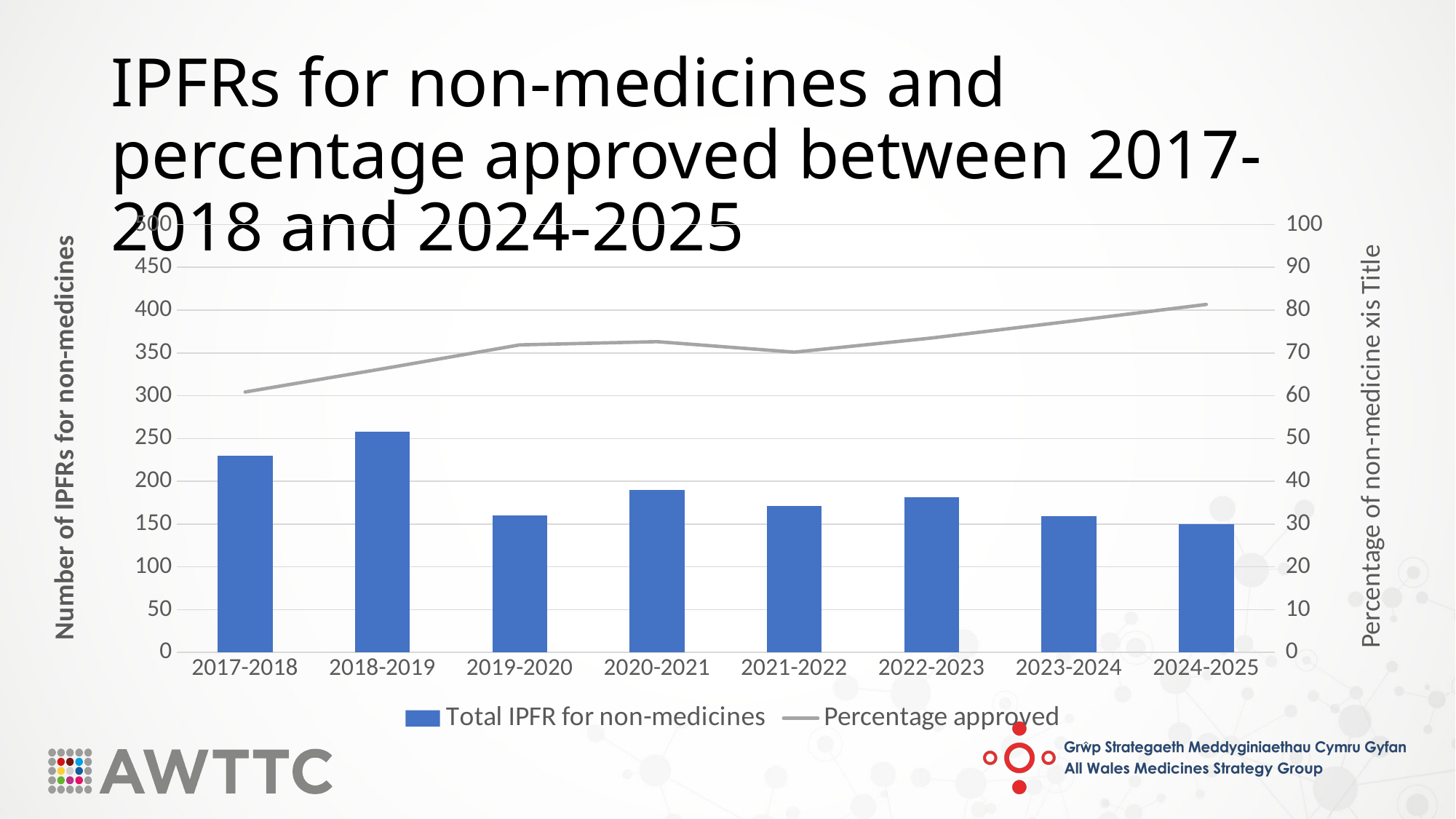
How many financial-year categories are shown on the x axis? 8 Which year has the lowest Total IPFR for non-medicines? 2024-2025 Does the Percentage approved line generally rise or fall from 2017-2018 to 2024-2025? Rise Is the Percentage approved in 2024-2025 greater or less than 70? greater Is the Total IPFR for non-medicines in 2019-2020 greater or less than 200? less Which year has the lowest Percentage approved? 2017-2018 How many series does the legend list? 2 What kind of chart is shown on the slide? A combined bar and line chart Is the Total IPFR for non-medicines in 2017-2018 greater or less than 200? greater Which year has a larger Total IPFR for non-medicines, 2020-2021 or 2021-2022? 2020-2021 Which year has the highest Total IPFR for non-medicines? 2018-2019 Which year has the highest Percentage approved? 2024-2025